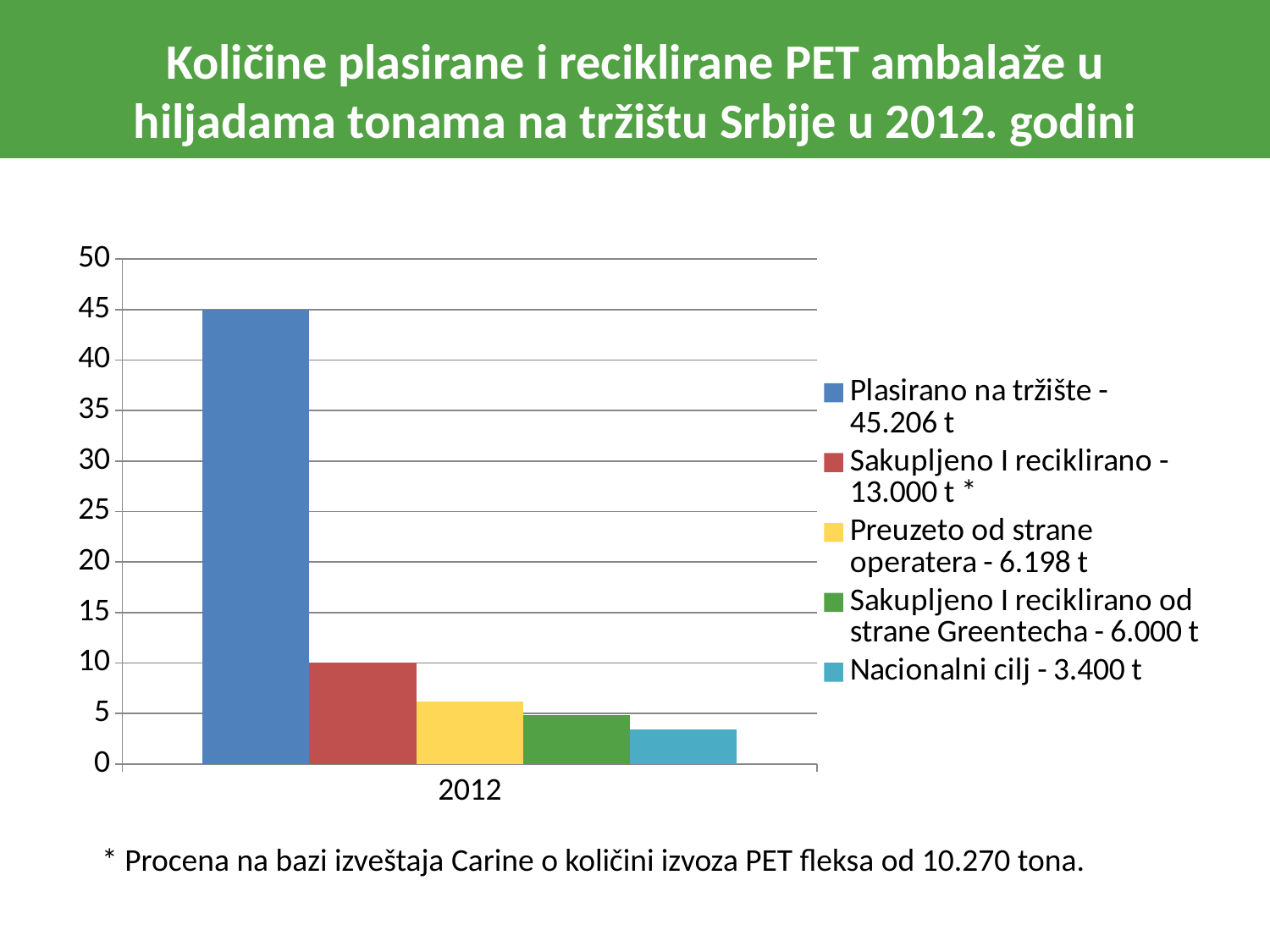
Is the plotted value for Nacionalni cilj greater or less than 5? less How many series does the legend list? 5 What value on the y axis does the bar for Sakupljeno I reciklirano reach? 10 What kind of chart is shown on the slide? bar chart Which bar is taller: Preuzeto od strane operatera or Nacionalni cilj? Preuzeto od strane operatera Which series has the tallest bar? Plasirano na tržište How many categories are shown on the x axis? 1 According to the legend, what quantity is given for Nacionalni cilj? 3.400 t Is the plotted value for Preuzeto od strane operatera greater or less than 5? greater What value on the y axis does the bar for Plasirano na tržište reach? 45 Which series has the shortest bar? Nacionalni cilj What is the difference between the plotted values for Plasirano na tržište and Sakupljeno I reciklirano? 35